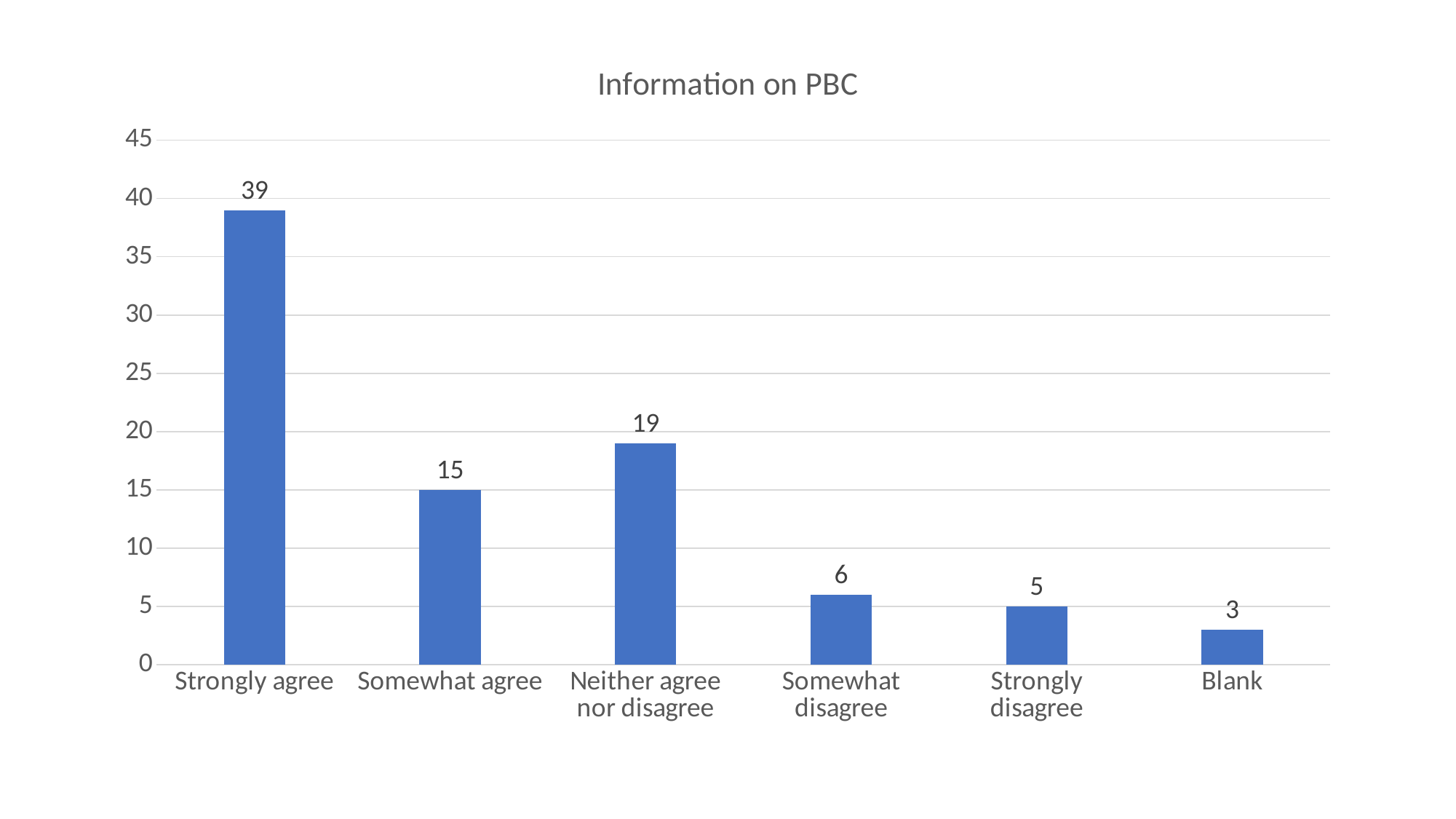
Which category has the highest value? Strongly agree How many categories are shown on the x axis? 6 What is the value for Strongly agree? 39 What kind of chart is shown on the slide? bar chart Which category has the lowest value? Blank Which is larger, the value for Somewhat agree or the value for Neither agree nor disagree? Neither agree nor disagree What is the value for Blank? 3 What is the difference between the values for Strongly disagree and Blank? 2 What is the value for Neither agree nor disagree? 19 What is the title of the chart? Information on PBC What is the difference between the values for Strongly agree and Somewhat agree? 24 Is the value for Somewhat disagree greater or less than 10? less